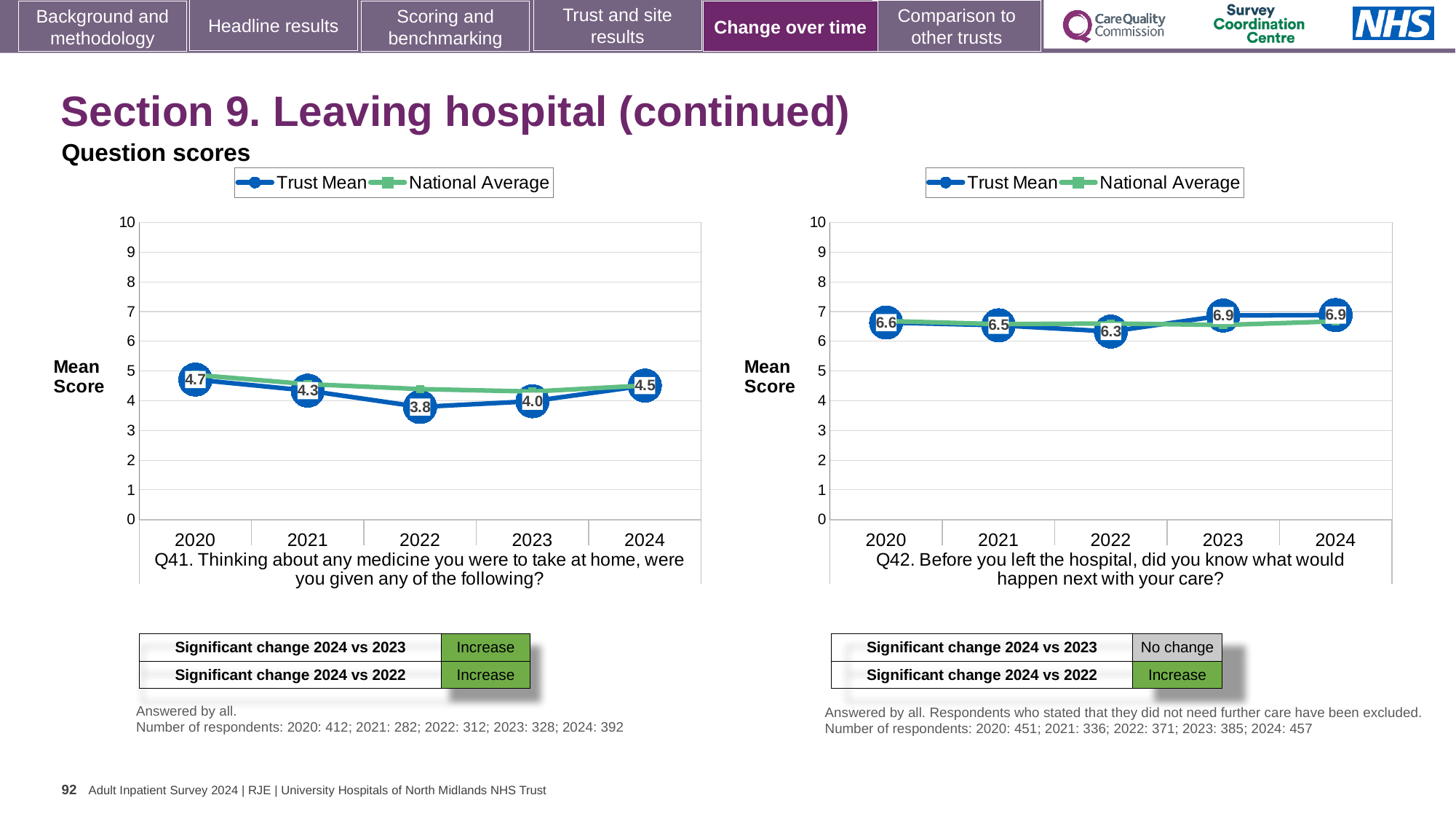
In the Q42 chart on the right, what is the difference between the Trust Mean scores for 2024 and 2022? 0.6 In the Q42 chart on the right, what is the Trust Mean score for 2020? 6.6 In the Q41 chart on the left, what is the Trust Mean score for 2022? 3.8 What type of chart is the Q42 chart on the right? line chart In the Q41 chart on the left, what is the Trust Mean score for 2024? 4.5 In the Q42 chart on the right, how many series does the legend list? 2 In the Q41 chart on the left, which year has the lowest Trust Mean score? 2022 In the Q41 chart on the left, what is the difference between the Trust Mean scores for 2024 and 2023? 0.5 In the Q41 chart on the left, is the National Average value for 2022 greater or less than 5? less In the Q41 chart on the left, which year has the highest Trust Mean score? 2020 In the Q42 chart on the right, which year has the lowest Trust Mean score? 2022 In the Q41 chart on the left, does the Trust Mean rise or fall from 2020 to 2022? fall